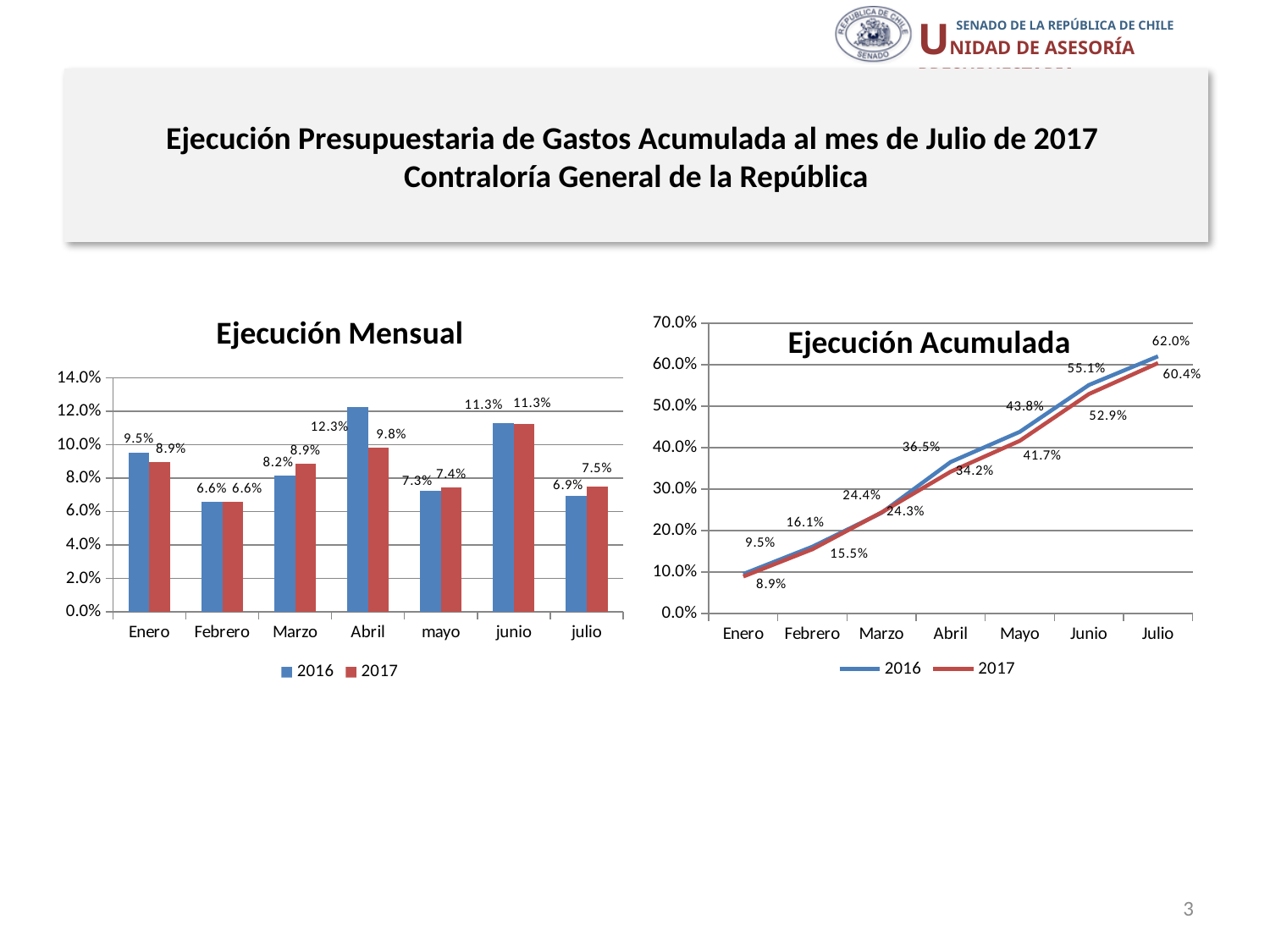
In the 'Ejecución Acumulada' chart, what is the difference between the 2016 and 2017 values in Julio? 1.6% In the 'Ejecución Mensual' chart, what is the value for 2017 in julio? 7.5% In the 'Ejecución Acumulada' chart, what is the value for 2017 in Junio? 52.9% In the 'Ejecución Acumulada' chart, what is the value for 2016 in Mayo? 43.8% In the 'Ejecución Mensual' chart, what is the difference between the 2016 and 2017 values in Abril? 2.5% In the 'Ejecución Mensual' chart, which month has the highest value for 2016? Abril In the 'Ejecución Mensual' chart, what is the value for 2016 in Abril? 12.3% In the 'Ejecución Mensual' chart, which is larger in Marzo: the 2016 value or the 2017 value? 2017 In the 'Ejecución Acumulada' chart, do the values rise or fall from Enero to Julio? Rise What kind of chart is 'Ejecución Mensual'? Bar chart How many series does the legend of the 'Ejecución Acumulada' chart list? 2 In the 'Ejecución Mensual' chart, which month has the lowest value for 2017? Febrero